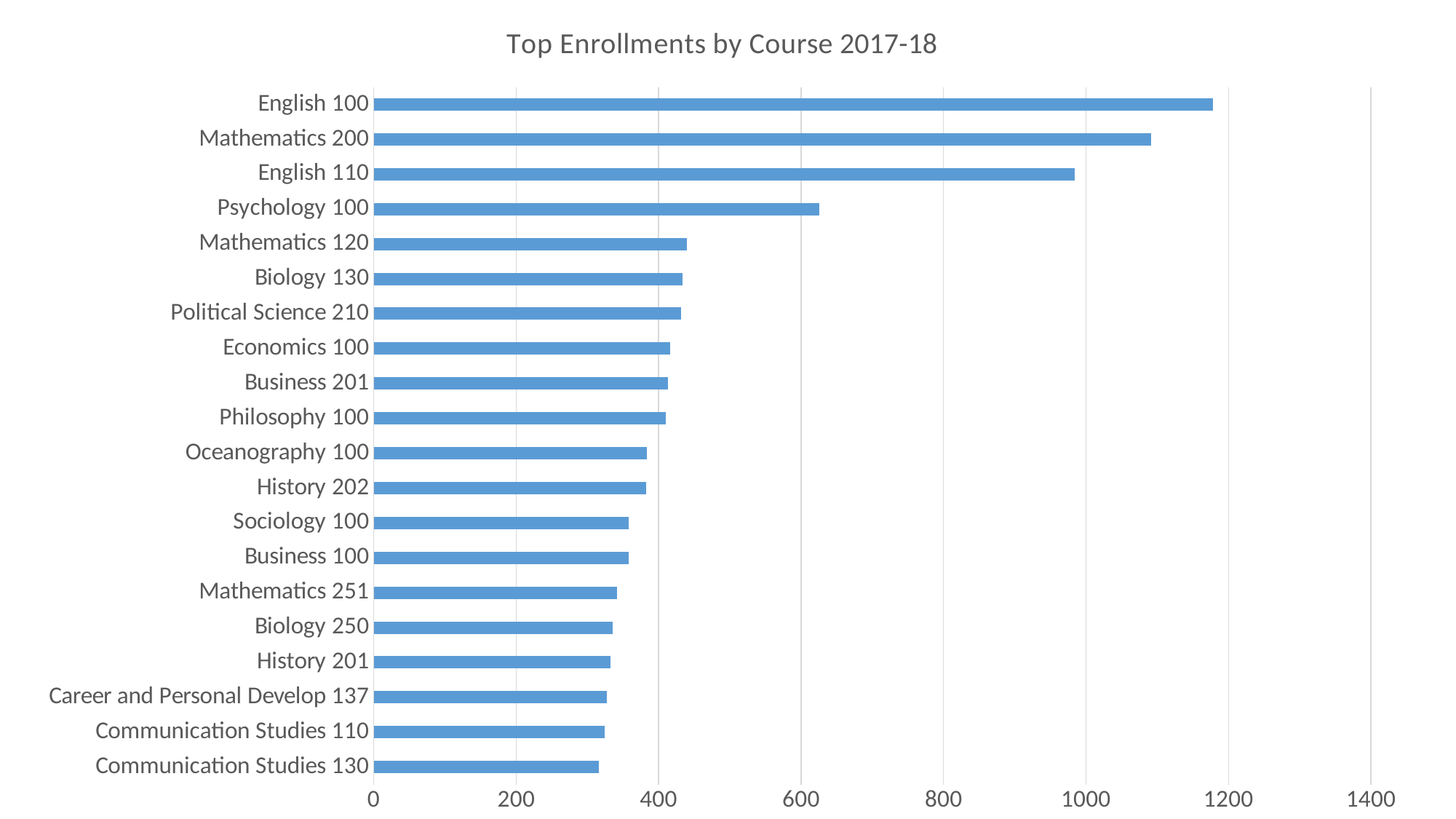
Which has the larger enrollment, Psychology 100 or Mathematics 120? Psychology 100 Is the value for Mathematics 200 greater or less than 1000? greater Which course has the highest enrollment? English 100 Is the value for Psychology 100 greater or less than 600? greater Is the value for Sociology 100 greater or less than 400? less How many courses are listed in the chart? 20 What is the title of the chart? Top Enrollments by Course 2017-18 Which has the larger enrollment, Oceanography 100 or Mathematics 251? Oceanography 100 What kind of chart is shown on the slide? bar chart